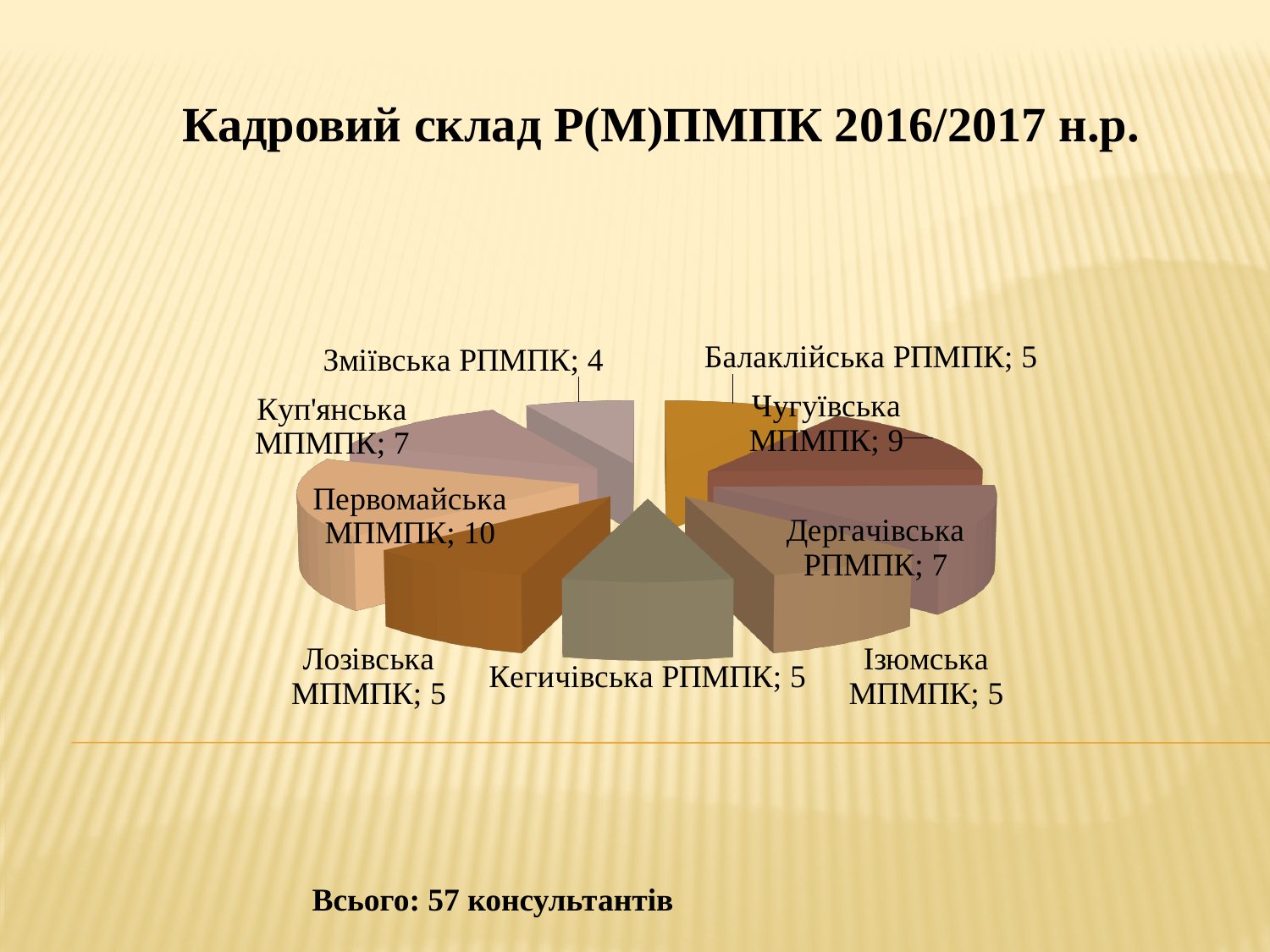
What type of chart is shown on the slide? pie chart What is the difference between the values for Куп'янська МПМПК and Балаклійська РПМПК? 2 What is the value for Чугуївська МПМПК? 9 What is the title of the chart on the slide? Кадровий склад Р(М)ПМПК 2016/2017 н.р. What is the difference between the values for Первомайська МПМПК and Зміївська РПМПК? 6 What is the value for Первомайська МПМПК? 10 How many slices does the pie chart have? 9 What is the total number of consultants across all slices of the pie chart? 57 Which category has the smallest value in the pie chart? Зміївська РПМПК What is the value for Зміївська РПМПК? 4 Which is larger, the value for Чугуївська МПМПК or the value for Дергачівська РПМПК? Чугуївська МПМПК Which category has the largest value in the pie chart? Первомайська МПМПК